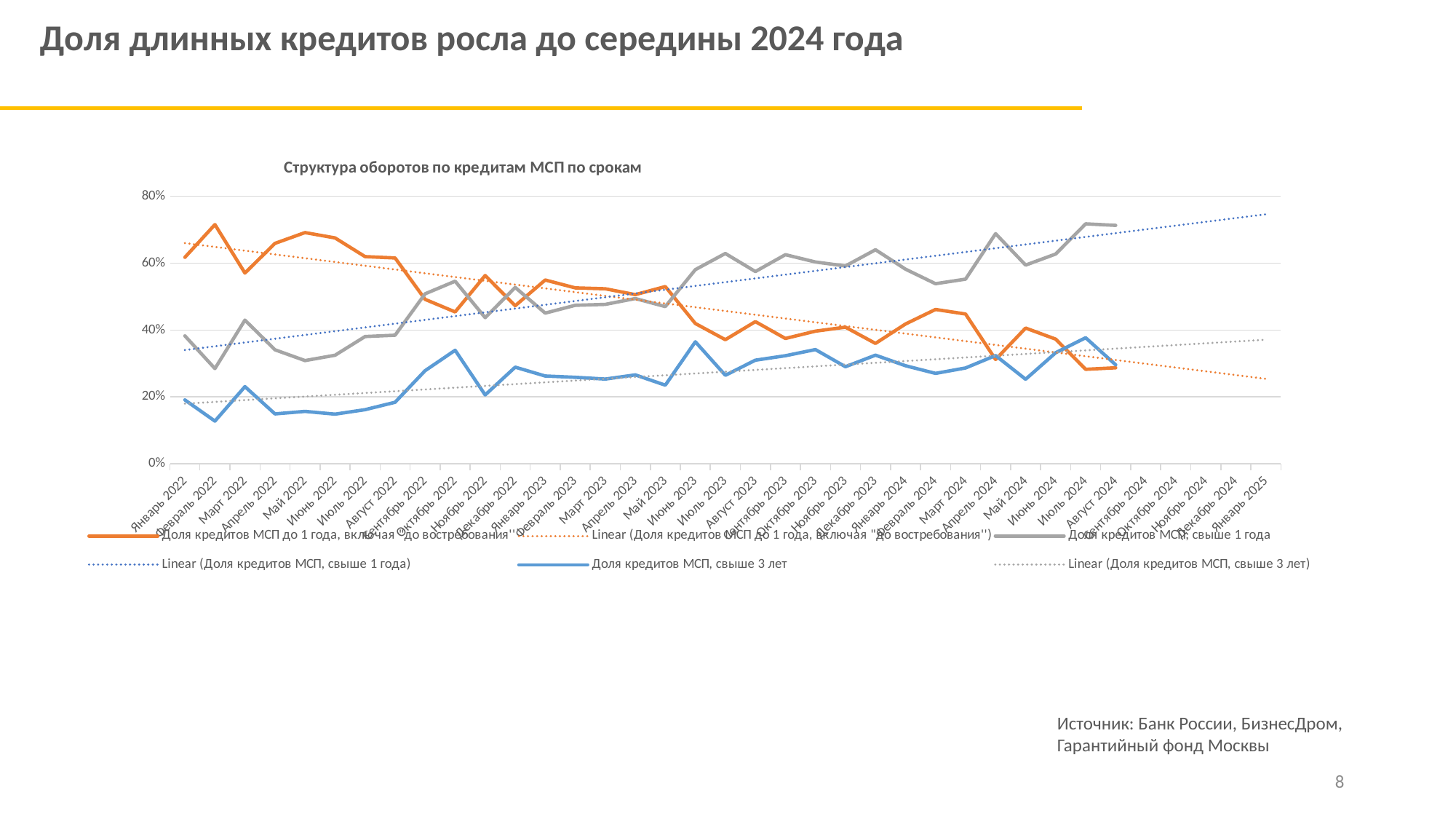
Is the value for "Доля кредитов МСП, свыше 1 года" in Февраль 2022 greater or less than 40%? less In Январь 2022, which is larger: "Доля кредитов МСП до 1 года, включая ''до востребования''" or "Доля кредитов МСП, свыше 3 лет"? Доля кредитов МСП до 1 года, включая ''до востребования'' How many entries does the chart legend list? 6 What is the title of the chart? Структура оборотов по кредитам МСП по срокам Is the value for "Доля кредитов МСП до 1 года, включая ''до востребования''" in Август 2024 greater or less than 40%? less In Август 2024, which is larger: "Доля кредитов МСП, свыше 1 года" or "Доля кредитов МСП до 1 года, включая ''до востребования''"? Доля кредитов МСП, свыше 1 года Is the value for "Доля кредитов МСП, свыше 1 года" in Июль 2024 greater or less than 60%? greater Does the series "Доля кредитов МСП, свыше 1 года" generally rise or fall from Январь 2022 to Август 2024? rise Which series has the highest value in Февраль 2022? Доля кредитов МСП до 1 года, включая ''до востребования'' What kind of chart is shown on the slide? Line chart